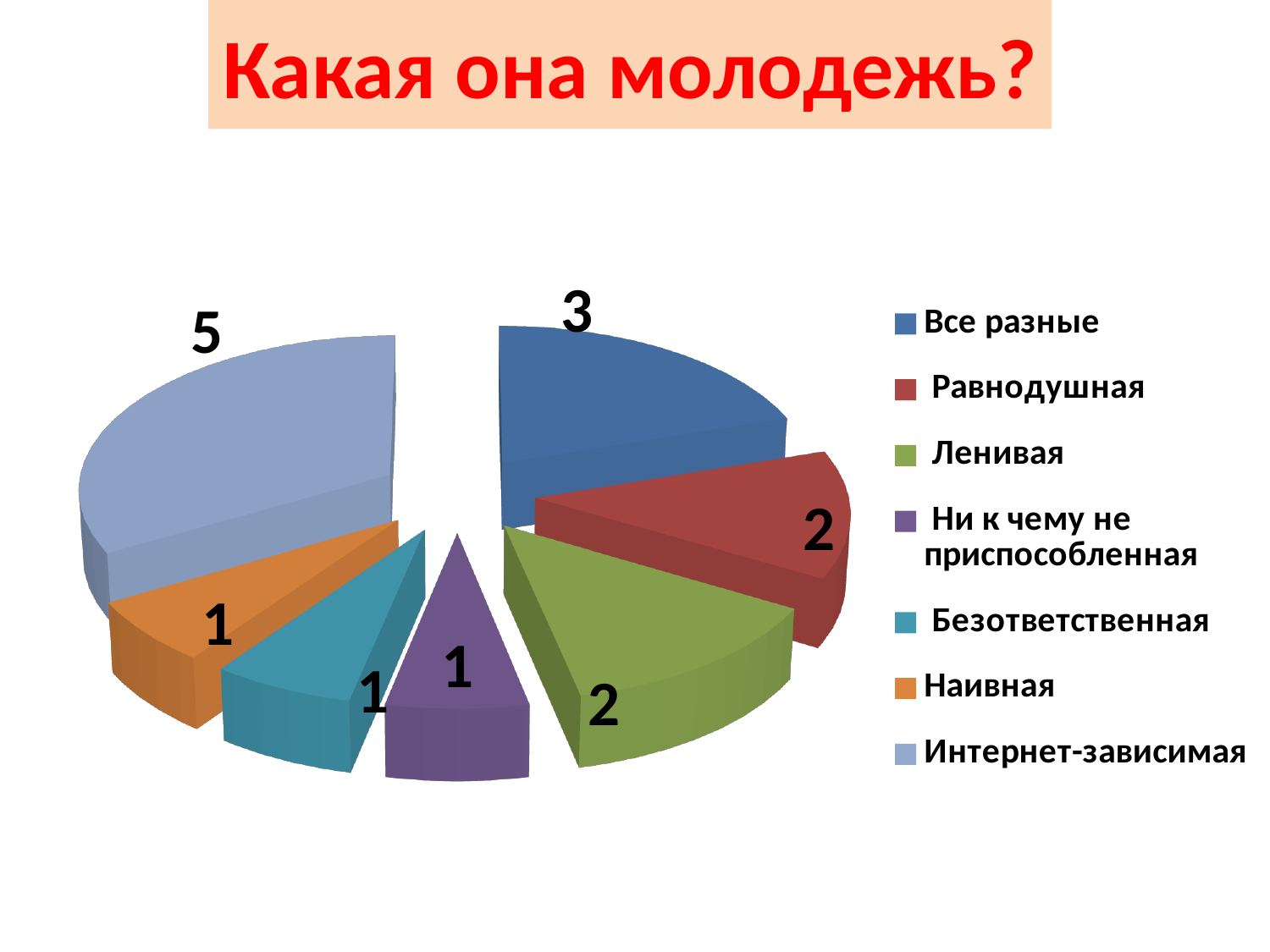
What is the value for Наивная? 1 Which is larger, the value for Ленивая or the value for Безответственная? Ленивая What is the value for Равнодушная? 2 How many categories does the pie chart have? 7 What is the difference between the values for Интернет-зависимая and Все разные? 2 Which category has the largest slice? Интернет-зависимая What is the total of all the slice values? 15 What is the title of the slide? Какая она молодежь? What is the value for Все разные? 3 What kind of chart is shown on the slide? pie chart What share of the total does Все разные represent? 20% What is the value for Интернет-зависимая? 5